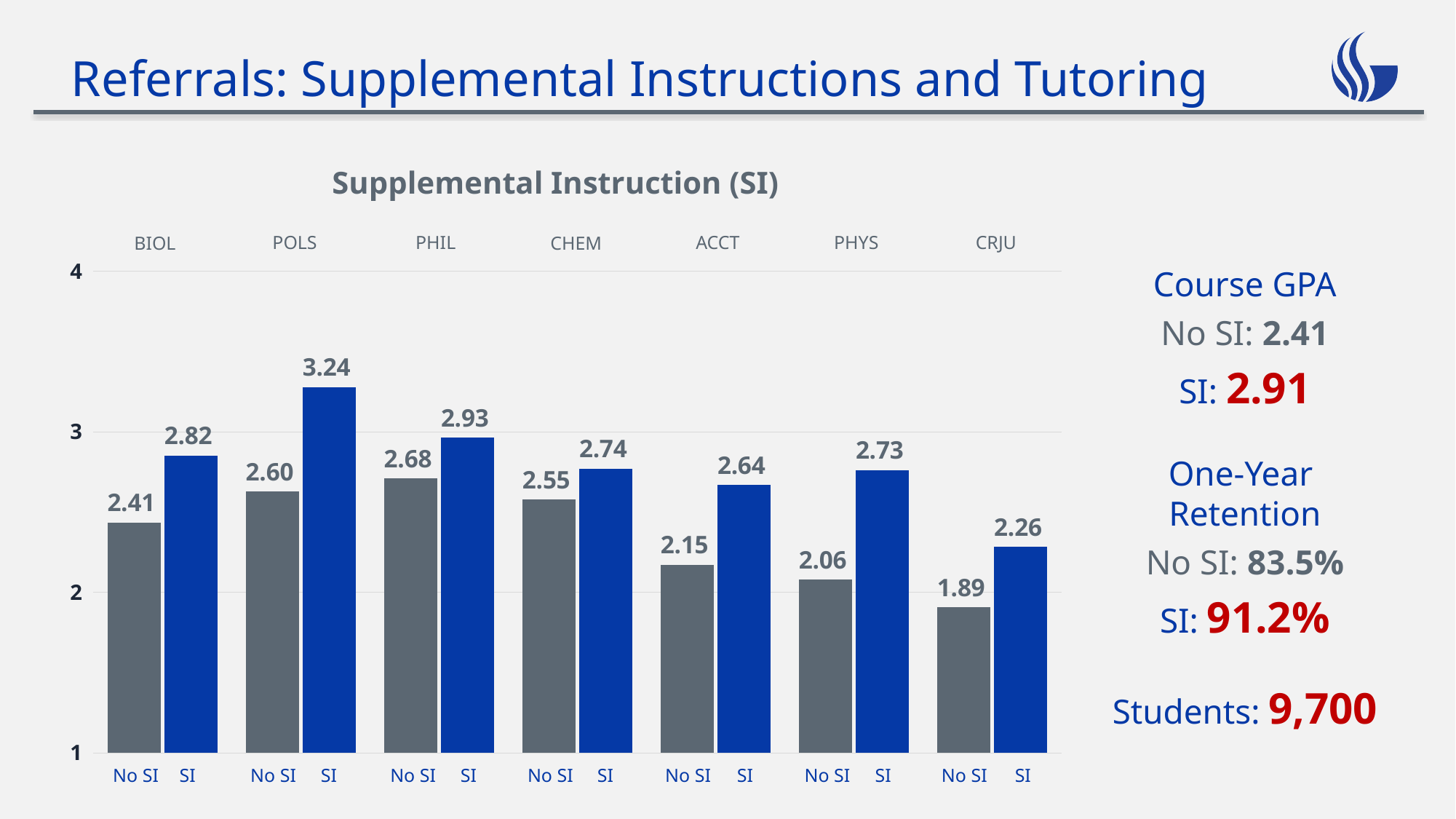
What is the title of the chart? Supplemental Instruction (SI) Which course has the lowest No SI value? CRJU Is the SI value for ACCT greater or less than 3? less What is the No SI value for CRJU? 1.89 What kind of chart is shown? bar chart What is the SI value for POLS? 3.24 How many courses are shown on the x axis? 7 What is the difference between the SI and No SI values for BIOL? 0.41 Which is larger, the No SI value for PHIL or the No SI value for CHEM? PHIL What is the difference between the SI values for POLS and PHIL? 0.31 What is the No SI value for PHYS? 2.06 Which course has the highest SI value? POLS